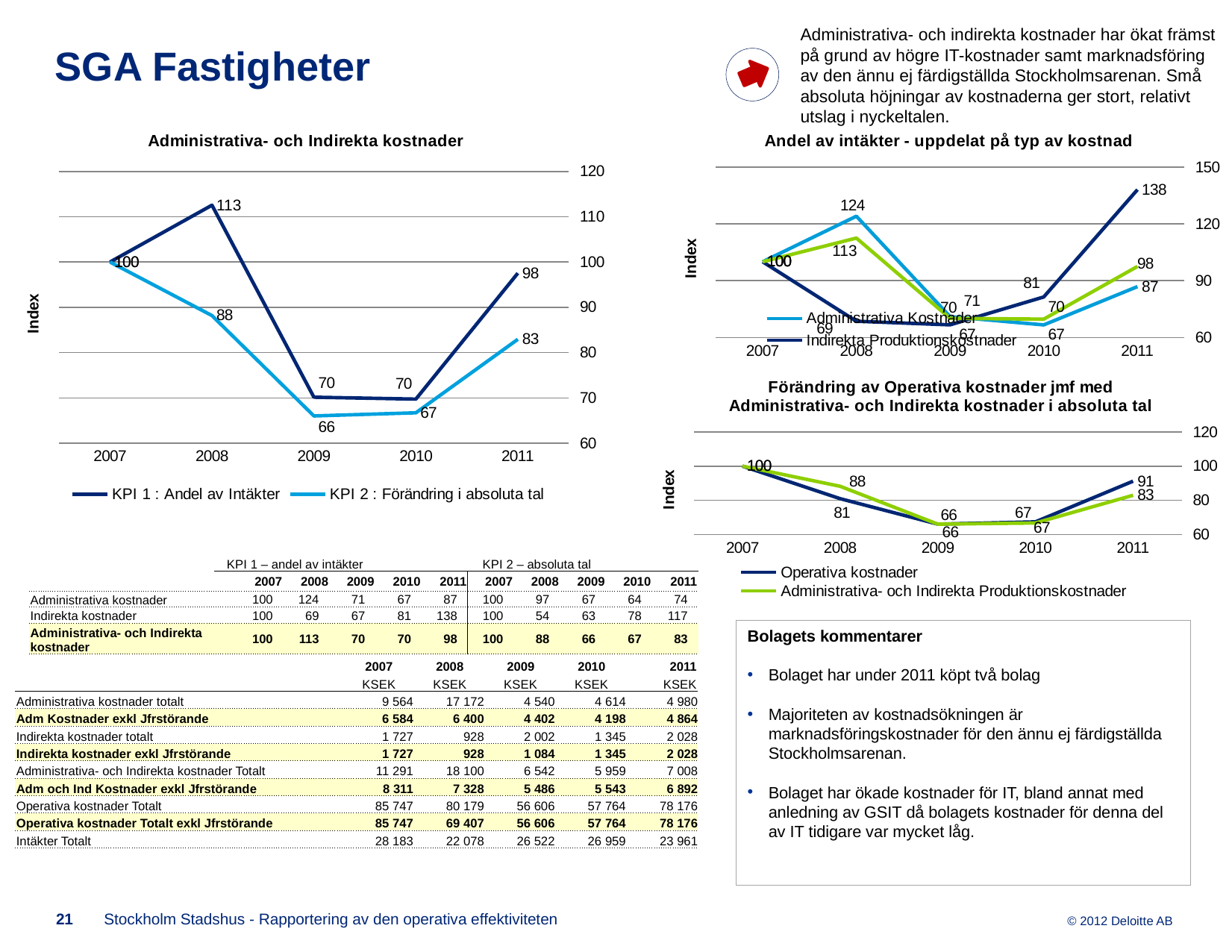
In the chart titled 'Administrativa- och Indirekta kostnader', how many series does the legend list? 2 In the chart titled 'Andel av intäkter - uppdelat på typ av kostnad', is the value of Indirekta Produktionskostnader in 2011 greater or less than 120? greater In the chart titled 'Administrativa- och Indirekta kostnader', what is the value of KPI 1 : Andel av Intäkter in 2008? 113 In the chart titled 'Förändring av Operativa kostnader jmf med Administrativa- och Indirekta kostnader i absoluta tal', which series has the higher value in 2011, Operativa kostnader or Administrativa- och Indirekta Produktionskostnader? Operativa kostnader What kind of chart is 'Administrativa- och Indirekta kostnader'? Line chart In the chart titled 'Förändring av Operativa kostnader jmf med Administrativa- och Indirekta kostnader i absoluta tal', what is the value of Operativa kostnader in 2008? 81 In the chart titled 'Andel av intäkter - uppdelat på typ av kostnad', what is the value of Indirekta Produktionskostnader in 2011? 138 In the chart titled 'Andel av intäkter - uppdelat på typ av kostnad', what is the value of Administrativa Kostnader in 2008? 124 In the chart titled 'Förändring av Operativa kostnader jmf med Administrativa- och Indirekta kostnader i absoluta tal', how many years are shown on the x axis? 5 In the chart titled 'Administrativa- och Indirekta kostnader', what is the difference between KPI 1 and KPI 2 in 2011? 15 In the chart titled 'Administrativa- och Indirekta kostnader', in which year is KPI 1 : Andel av Intäkter highest? 2008 In the chart titled 'Administrativa- och Indirekta kostnader', what is the value of KPI 2 : Förändring i absoluta tal in 2009? 66